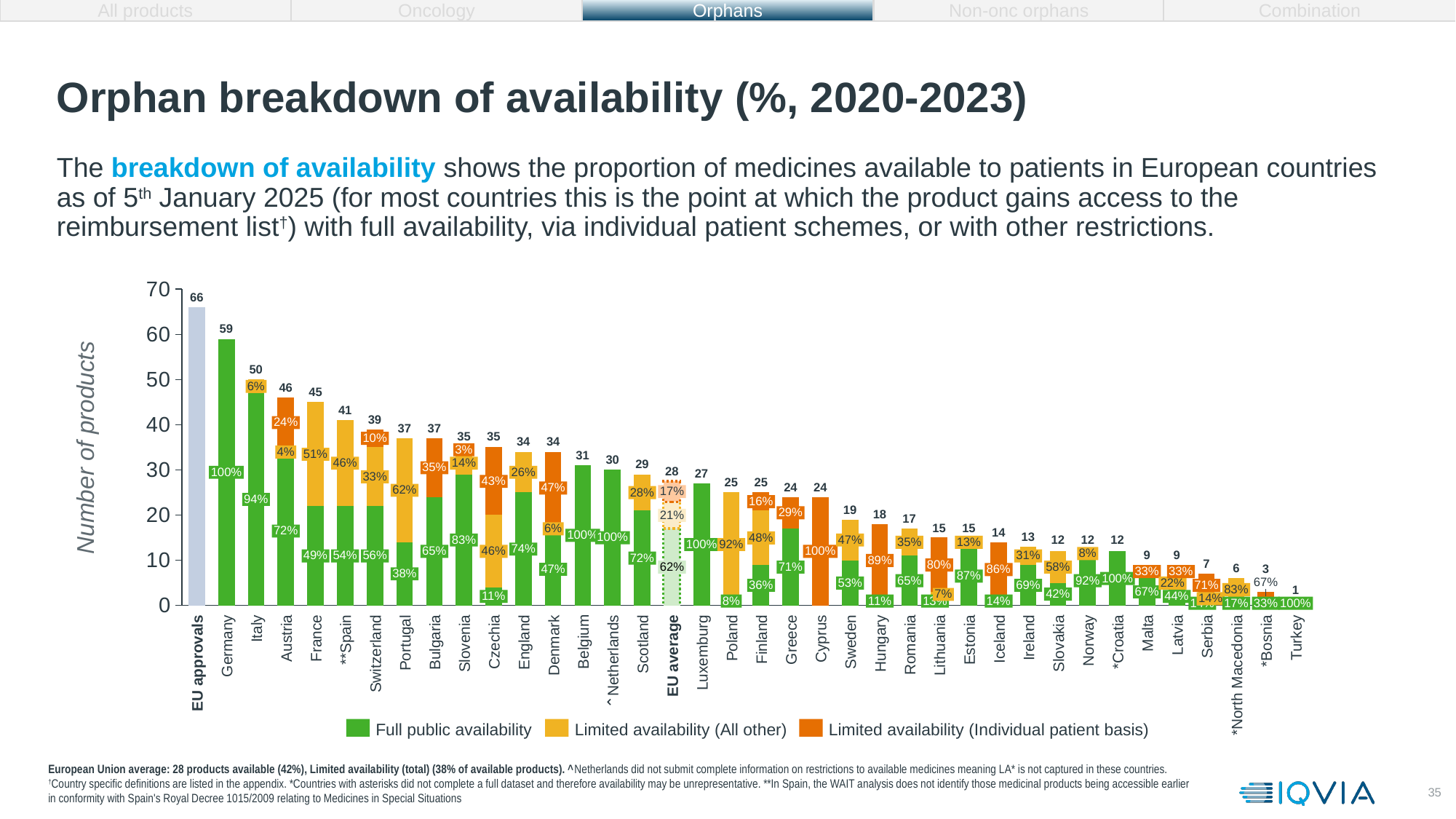
What is the difference between the total for EU approvals and the total for Germany? 7 Is the total for Sweden greater or less than 20? less Which bar has the highest total number of products? EU approvals Which has a higher total number of products, Italy or France? Italy What is the total number of products shown for Germany? 59 What kind of chart is shown on the slide? Stacked bar chart What is the total number of products shown for EU average? 28 How many bars (categories) are shown on the x axis? 38 How many series does the legend list? 3 Do the bar totals rise or fall moving from left to right along the x axis? Fall Which country has the lowest total number of products? Turkey What is the total number of products shown for Scotland? 29